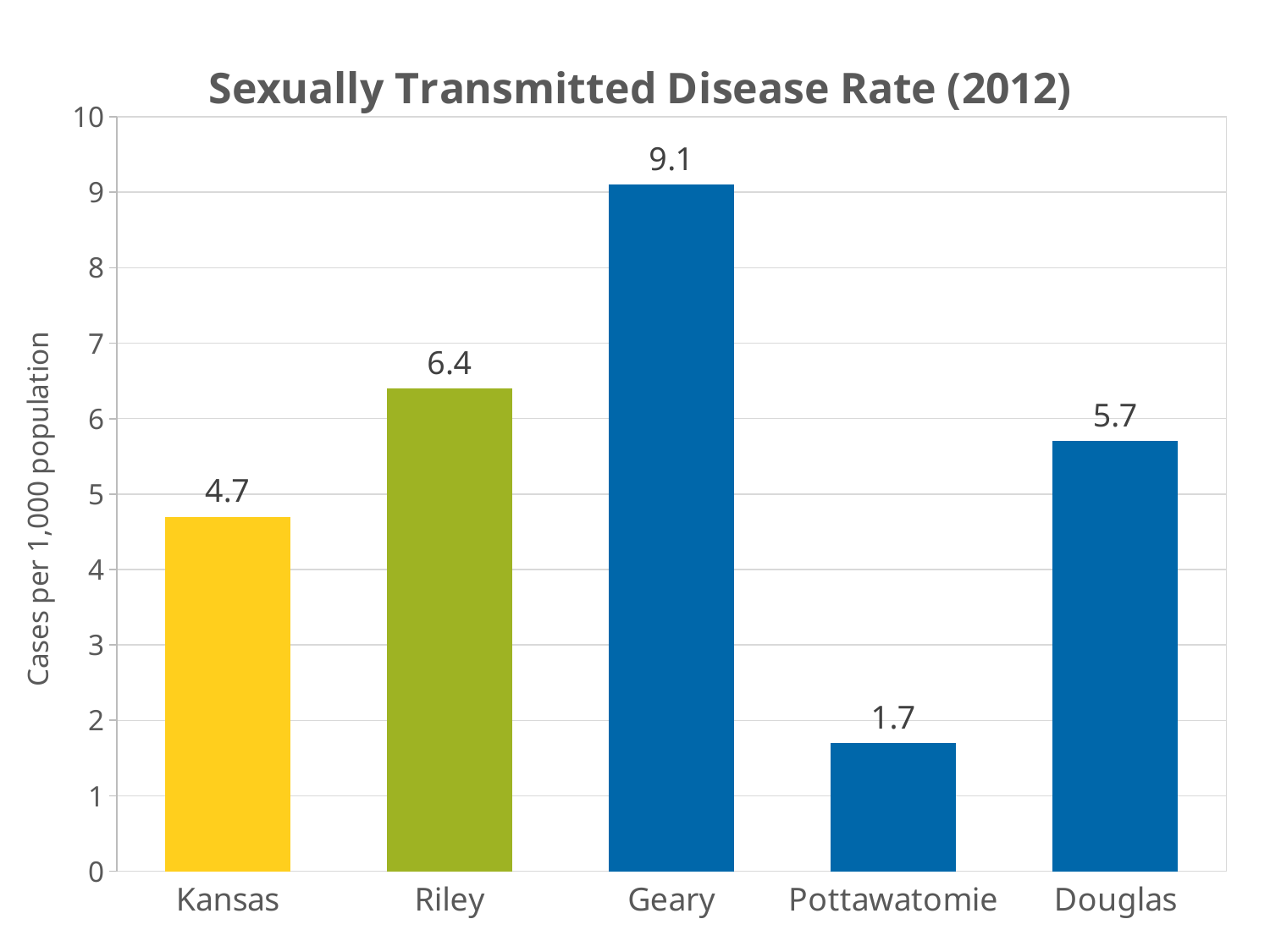
What kind of chart is shown on the slide? Bar chart What is the sexually transmitted disease rate for Geary? 9.1 What is the label on the vertical axis? Cases per 1,000 population What is the sexually transmitted disease rate for Pottawatomie? 1.7 Which category has the lowest rate? Pottawatomie What is the difference between the rates for Douglas and Kansas? 1.0 How many categories are shown on the x axis? 5 What is the value shown for Kansas? 4.7 Which has a higher rate, Riley or Douglas? Riley Is the value for Douglas greater or less than 5? greater What is the difference between the rates for Geary and Riley? 2.7 Which category has the highest rate? Geary